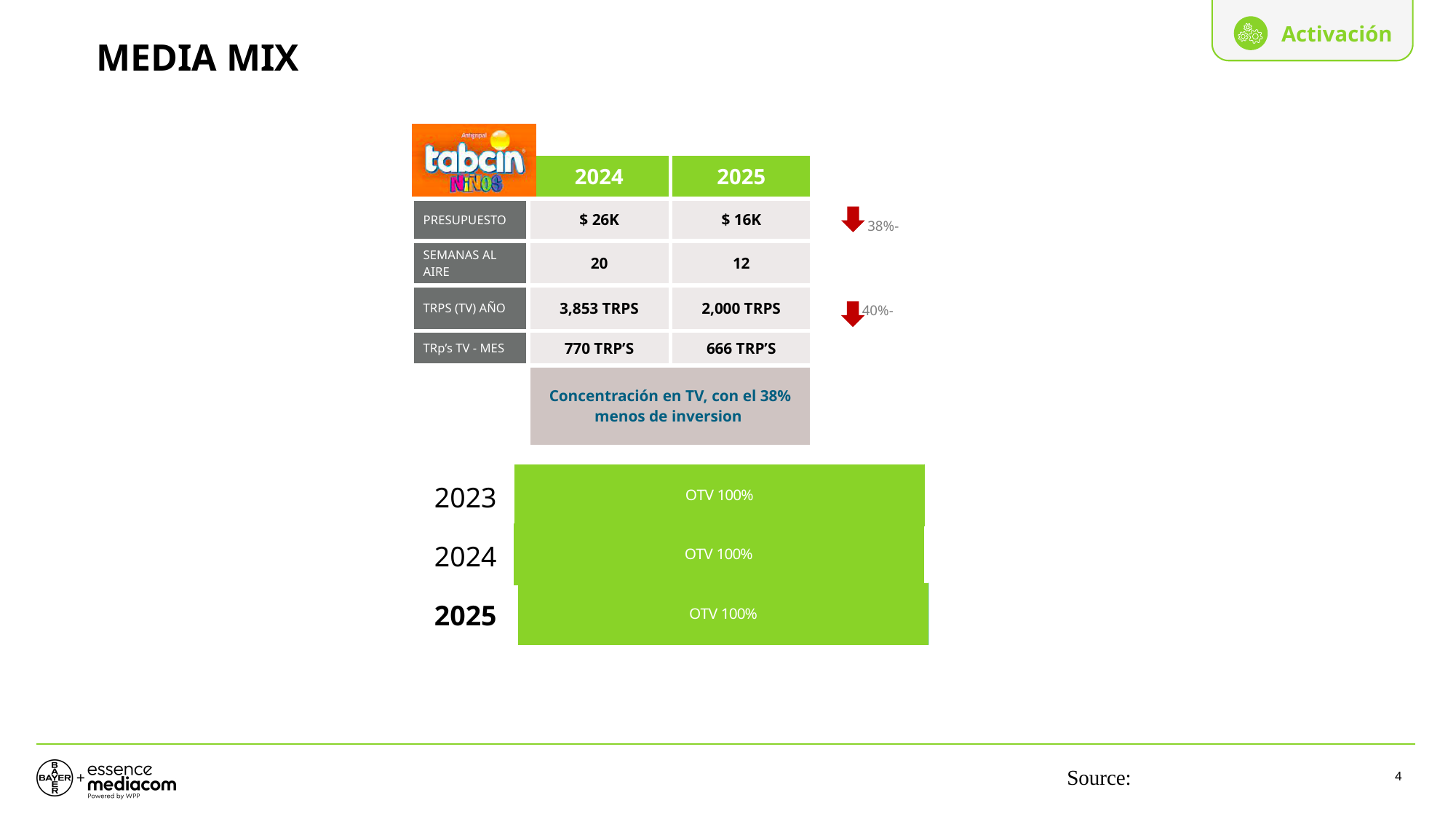
In the bar chart, what is the OTV share for 2025? OTV 100% What colour are the bars in the bar chart? green In the bar chart, does the OTV share rise, fall, or stay the same from 2023 to 2025? stay the same How many media channels (series) are shown in the bar chart? 1 In the bar chart, what is the total of the 2025 bar? 100% What kind of chart is shown at the bottom of the slide under the table? bar chart In the bar chart, what is the OTV share for 2023? OTV 100% How many years (categories) are shown in the bar chart? 3 Which media channel is labelled on the bars of the bar chart? OTV In the bar chart, what is the OTV share for 2024? OTV 100%